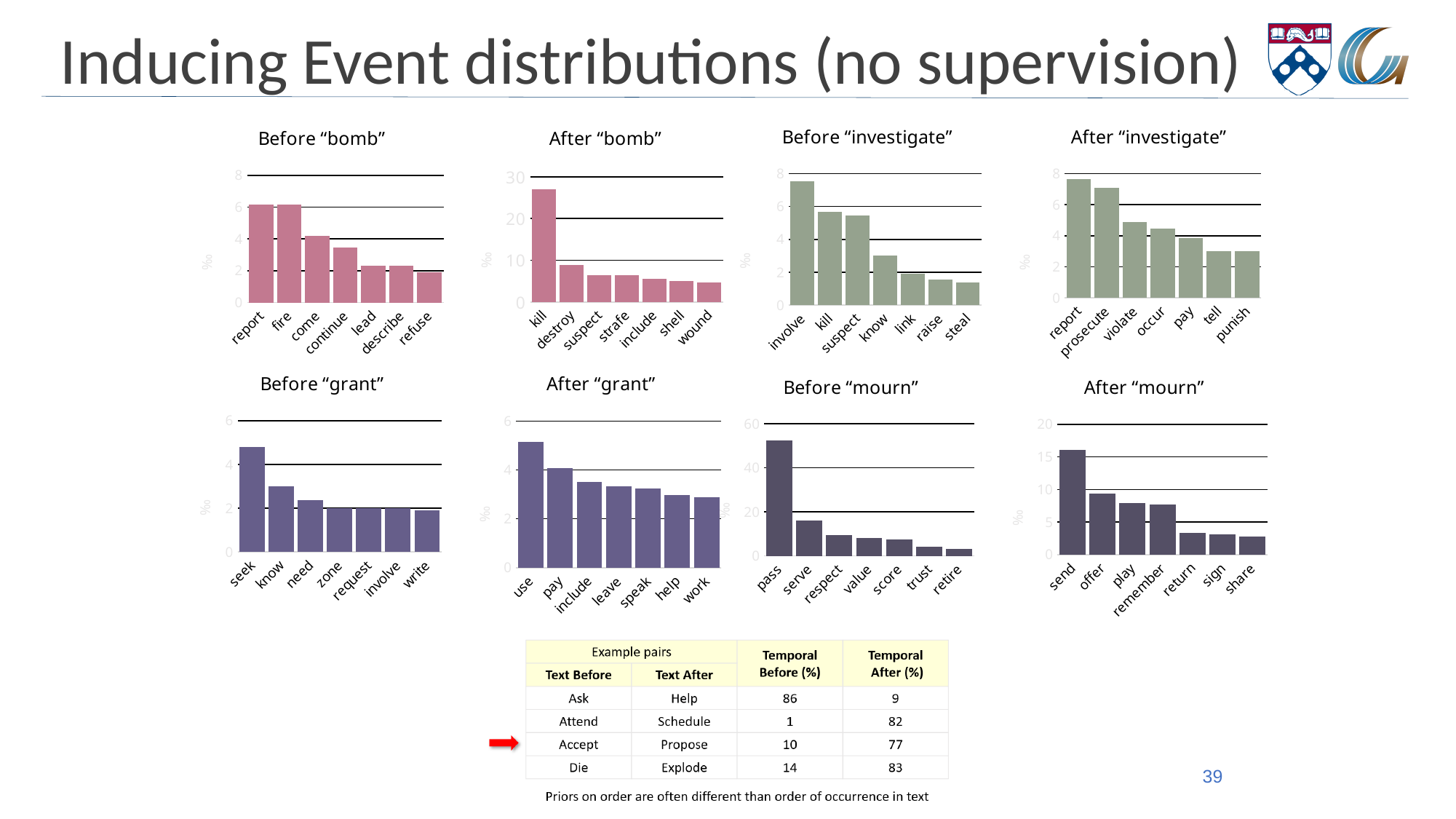
In the After "bomb" chart, is the value for kill greater or less than 20? greater In the Before "investigate" chart, is the value for know greater or less than 4? less In the After "bomb" chart, which is larger, the value for kill or the value for destroy? kill In the Before "bomb" chart, how many categories are shown on the x axis? 7 In the Before "mourn" chart, which category has the highest value? pass In the Before "grant" chart, which category has the highest value? seek In the After "grant" chart, is the value for use greater or less than 4? greater In the After "bomb" chart, which category has the highest value? kill What kind of chart is the After "investigate" chart? bar chart In the After "mourn" chart, do the values rise or fall from left to right along the x axis? fall